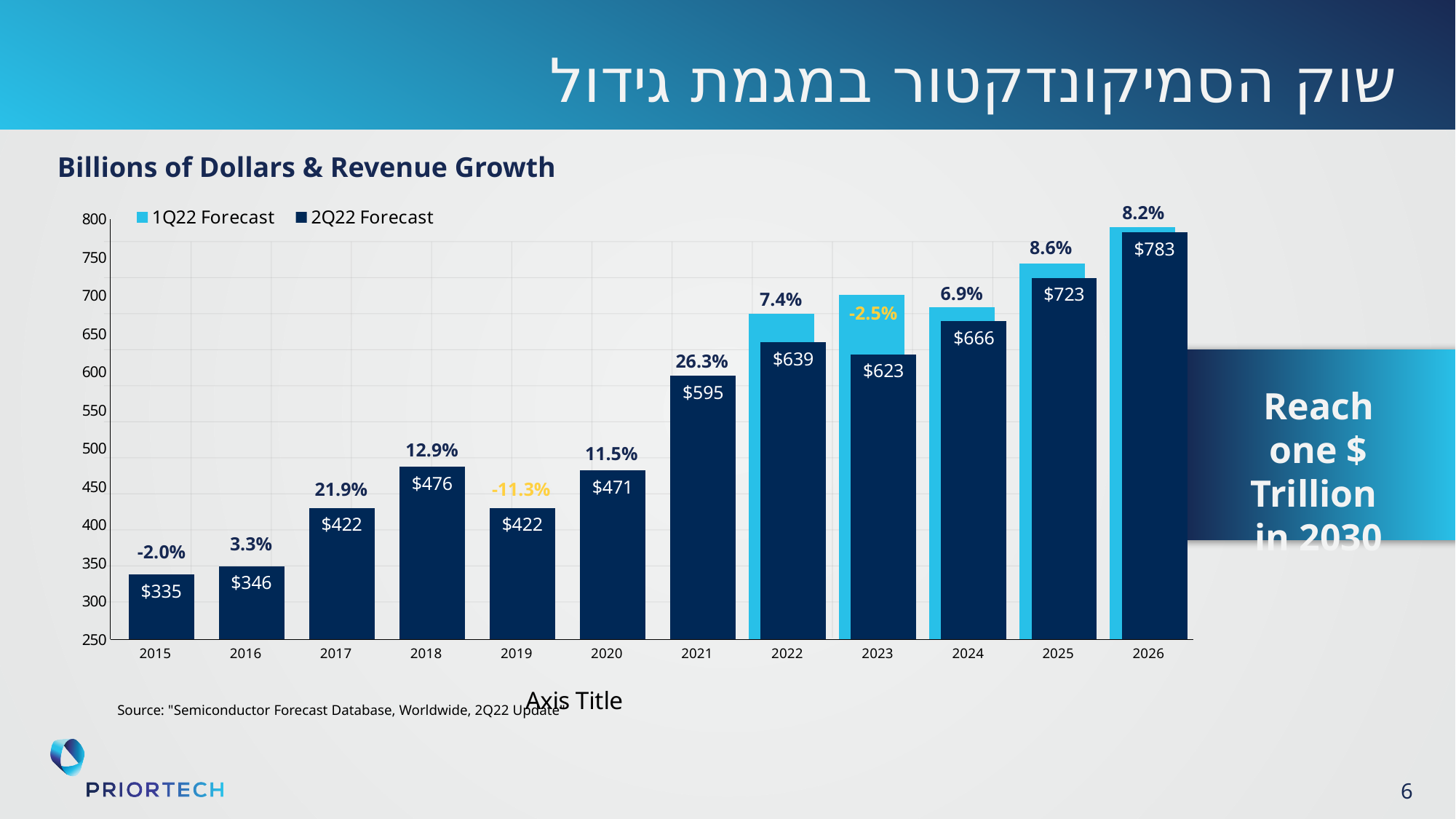
How many years are shown on the x axis? 12 What are the two series named in the legend? 1Q22 Forecast and 2Q22 Forecast What is the difference between the 2Q22 Forecast values for 2026 and 2025? $60 Which year has the highest 2Q22 Forecast value? 2026 What growth rate is shown above the bar for 2021? 26.3% Is the 1Q22 Forecast value for 2022 greater or less than 650? greater How many series does the legend list? 2 What kind of chart is shown on the slide? bar chart What is the 2Q22 Forecast value for 2021? $595 Which year has the lowest 2Q22 Forecast value? 2015 Which year has the larger 2Q22 Forecast value, 2022 or 2023? 2022 Do the 2Q22 Forecast values rise or fall from 2015 to 2018? rise